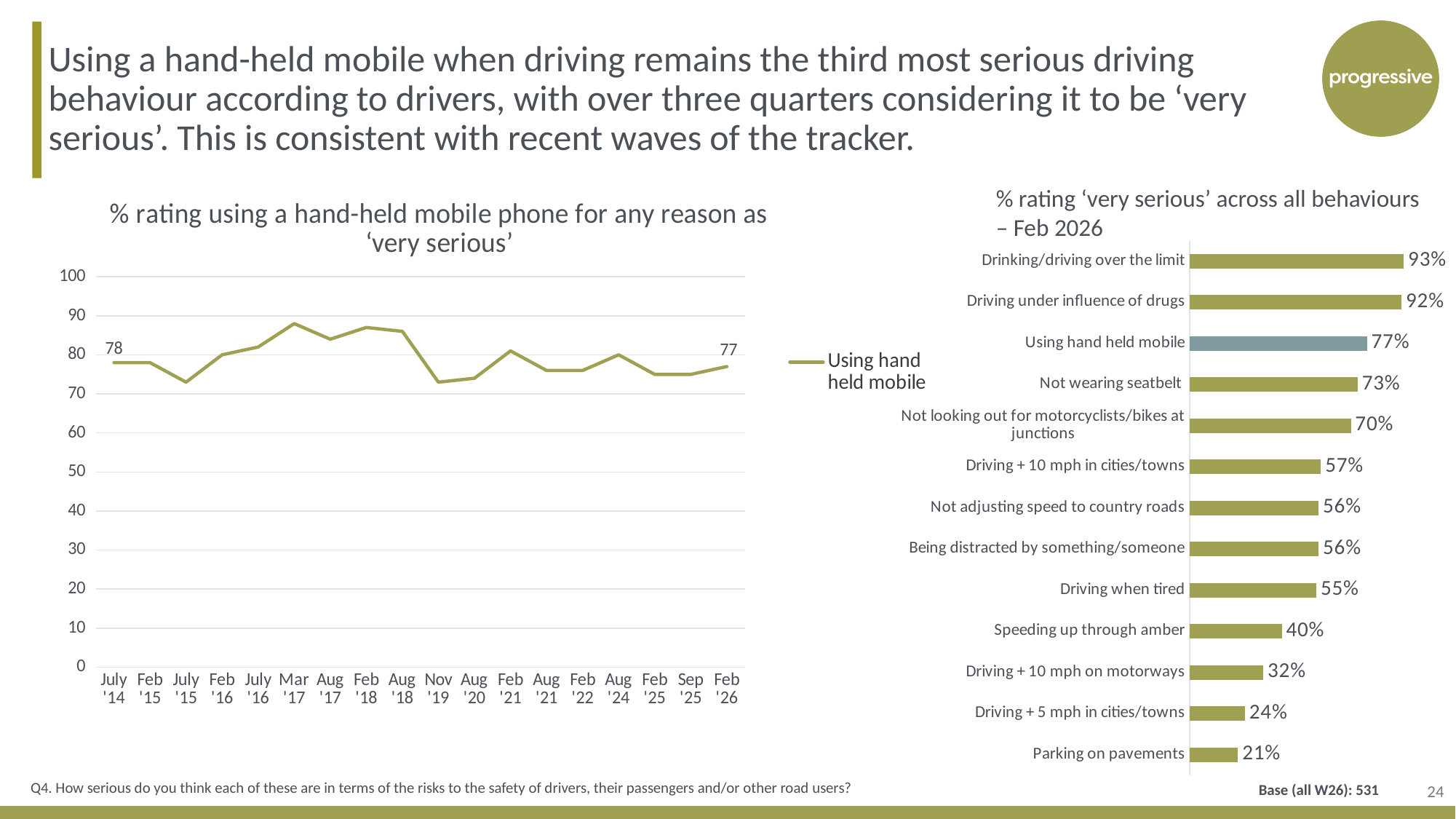
How many time points are shown on the x axis of the line chart on the left? 18 In the line chart on the left, is the value for July '15 greater or less than 80? less In the chart titled '% rating ‘very serious’ across all behaviours – Feb 2026', which behaviour has the lowest value? Parking on pavements In the chart titled '% rating ‘very serious’ across all behaviours – Feb 2026', what is the value for 'Using hand held mobile'? 77% In the chart titled '% rating ‘very serious’ across all behaviours – Feb 2026', what is the difference between 'Drinking/driving over the limit' and 'Using hand held mobile'? 16 percentage points In the chart titled '% rating ‘very serious’ across all behaviours – Feb 2026', which is larger: 'Not wearing seatbelt' or 'Driving when tired'? Not wearing seatbelt In the line chart on the left, what is the value for July '14? 78 How many behaviours are listed in the chart titled '% rating ‘very serious’ across all behaviours – Feb 2026'? 13 In the line chart on the left, what is the value for Feb '26? 77 What type of chart is the chart on the right of the slide? Bar chart In the chart titled '% rating ‘very serious’ across all behaviours – Feb 2026', which behaviour has the highest value? Drinking/driving over the limit In the chart titled '% rating ‘very serious’ across all behaviours – Feb 2026', what is the value for 'Speeding up through amber'? 40%